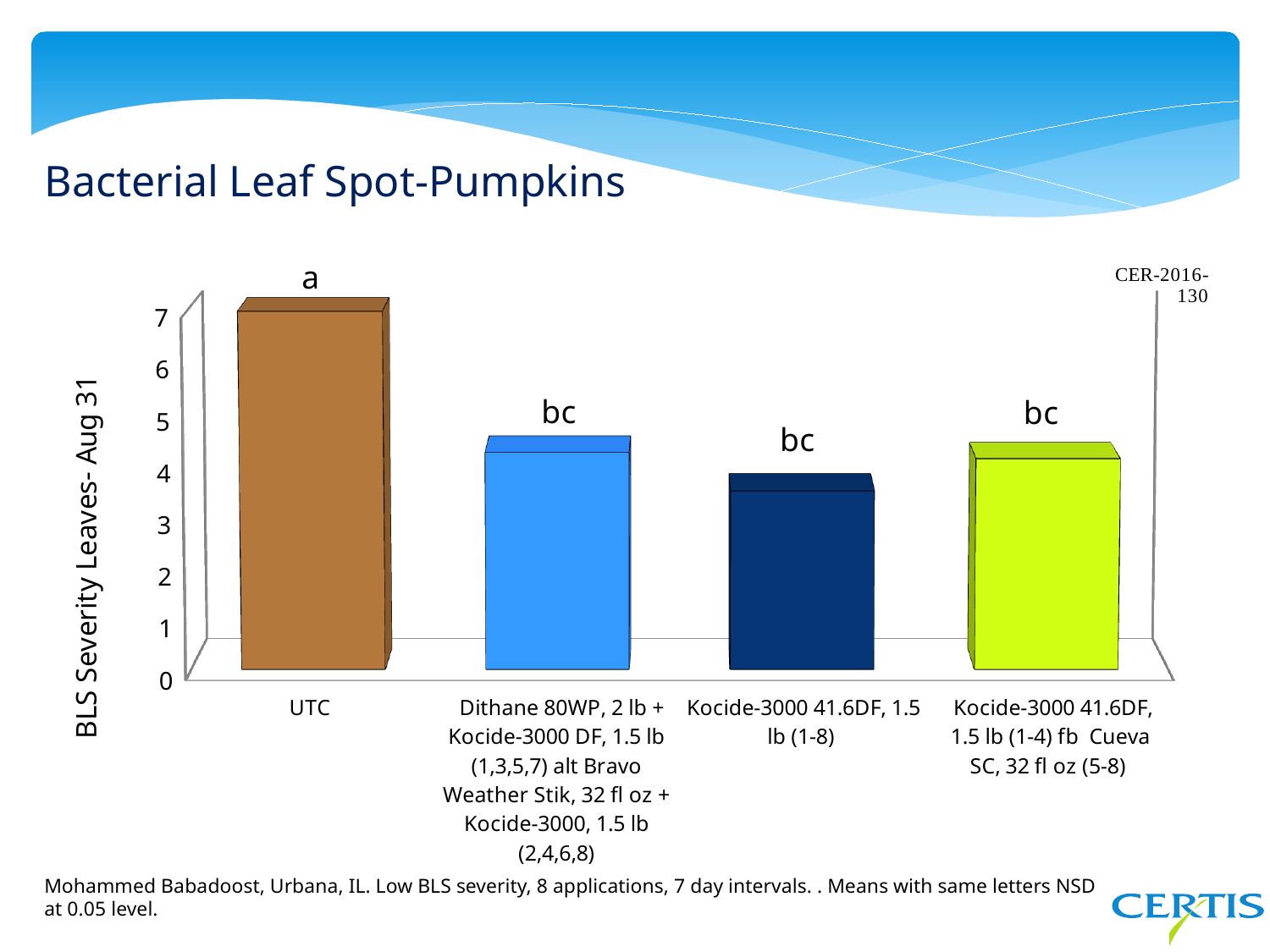
What statistical letter is shown above the UTC bar? a How many treatment categories are plotted in the chart? 4 What kind of chart is shown on the slide? bar chart Which treatment has the lowest BLS severity? Kocide-3000 41.6DF, 1.5 lb (1-8) Is the value for the Dithane 80WP + Kocide-3000 alt Bravo Weather Stik + Kocide-3000 treatment greater or less than 6? less Is the value for Kocide-3000 41.6DF, 1.5 lb (1-4) fb Cueva SC, 32 fl oz (5-8) greater or less than 3? greater Which treatment has the highest BLS severity? UTC Which has a higher BLS severity, the Dithane 80WP alt Bravo Weather Stik treatment or Kocide-3000 41.6DF, 1.5 lb (1-8)? Dithane 80WP alt Bravo Weather Stik treatment Is the value for Kocide-3000 41.6DF, 1.5 lb (1-8) greater or less than 5? less What is the title of the vertical axis? BLS Severity Leaves- Aug 31 Which has a higher BLS severity, UTC or Kocide-3000 41.6DF, 1.5 lb (1-8)? UTC